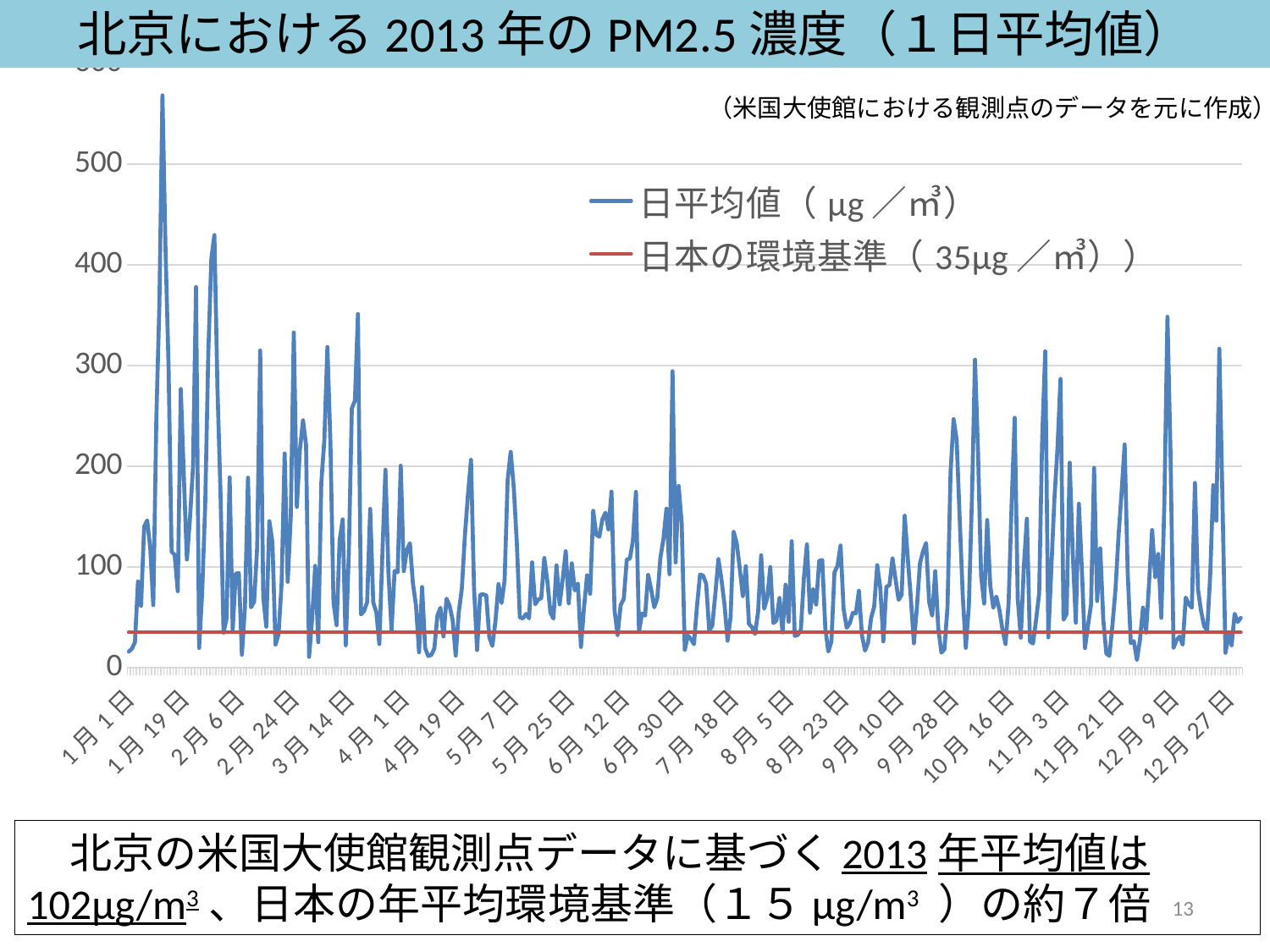
In which month does the highest daily average value of the year occur? 1月 Is the peak of the daily average line near 6月30日 greater or less than 200? greater Is the daily average value on 1月1日 greater or less than 100? less Which is larger: the peak daily average in mid-January or the peak near 10月16日? the peak in mid-January What kind of chart is shown on the slide? line chart What is the title of the chart? 北京における 2013 年の PM2.5 濃度（１日平均値） Is the peak of the daily average line near 12月9日 greater or less than 300? greater How many series does the legend list? 2 What value does the legend give for the Japanese environmental standard (日本の環境基準) line? 35µg／m³ Which colour is used for the 日平均値 series? blue